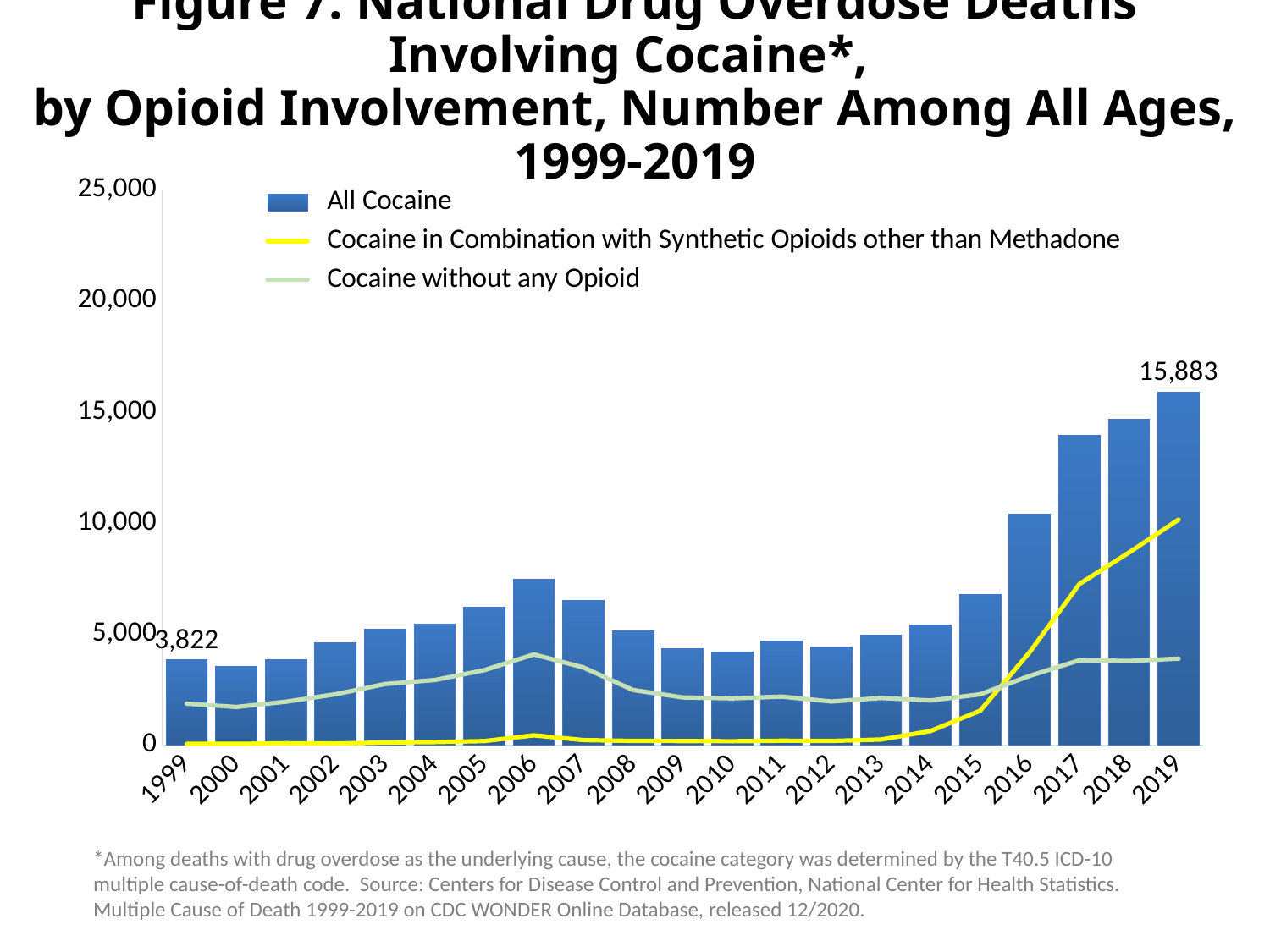
By how much did All Cocaine overdose deaths increase from 1999 to 2019? 12,061 Is the value for Cocaine in Combination with Synthetic Opioids other than Methadone in 2015 greater or less than 5,000? less What colour is the line for Cocaine in Combination with Synthetic Opioids other than Methadone? yellow Do All Cocaine overdose deaths rise or fall from 2014 to 2019? rise In which year is the All Cocaine bar lowest? 2000 In which year is the All Cocaine bar highest? 2019 How many series does the legend list? 3 What is the number of All Cocaine overdose deaths in 1999? 3,822 How many years are shown on the x axis? 21 Is the All Cocaine value for 2017 greater or less than 10,000? greater Which year has more All Cocaine overdose deaths, 2006 or 2010? 2006 What is the number of All Cocaine overdose deaths in 2019? 15,883